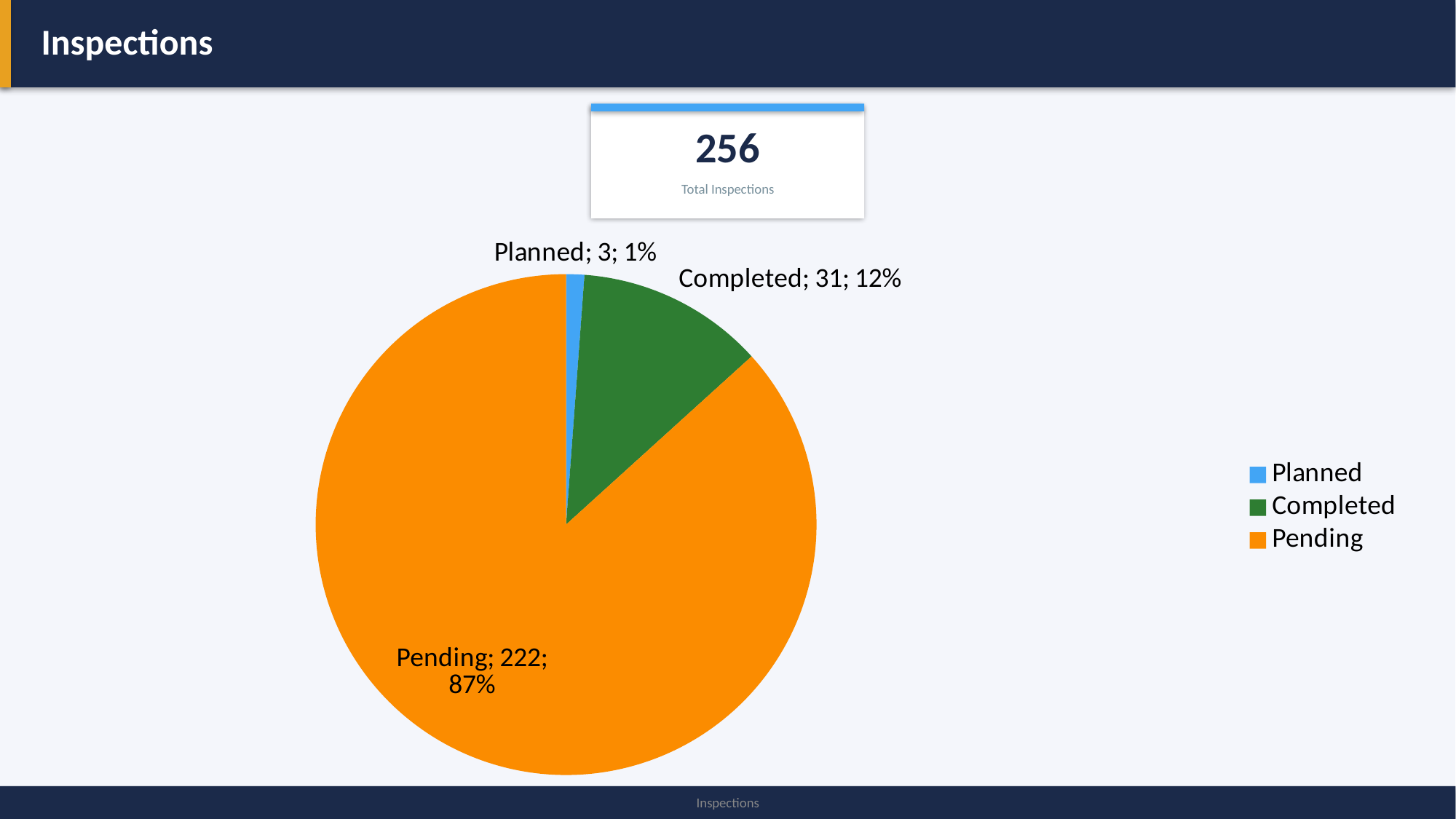
Which category has the smallest slice of the pie? Planned Which category has the largest slice of the pie? Pending What share of the pie does the Pending slice represent? 87% How many categories does the pie chart have? 3 How many inspections are Planned? 3 What is the difference between the Pending and Completed counts? 191 Which is larger, the Completed count or the Planned count? Completed What share of the pie does the Completed slice represent? 12% What colour is the Pending slice? orange How many inspections are Pending? 222 What kind of chart is shown on the slide? pie chart How many inspections are Completed? 31